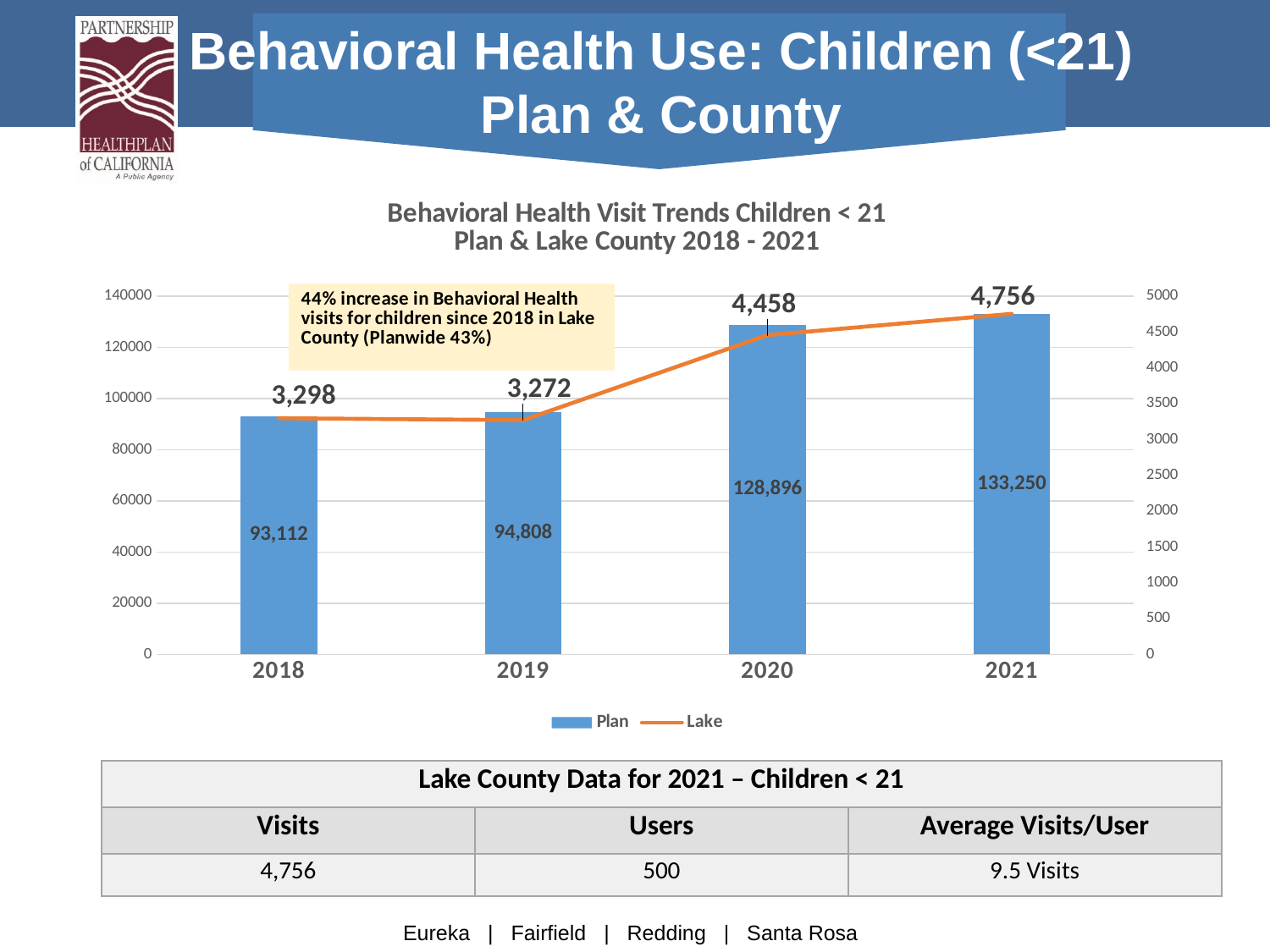
What is the Plan value for 2018? 93,112 What is the difference between the Lake values for 2021 and 2020? 298 What is the Plan value for 2020? 128,896 Which year has the highest Plan value? 2021 How many series does the legend list? 2 What is the difference between the Plan values for 2021 and 2018? 40,138 How is the Plan series drawn on the chart? As bars (a bar chart) Which is larger, the Lake value for 2018 or the Lake value for 2019? 2018 How many years are shown on the x axis? 4 Do the Plan values rise or fall from 2018 to 2021? Rise What is the Lake value for 2019? 3,272 Which year has the lowest Lake value? 2019